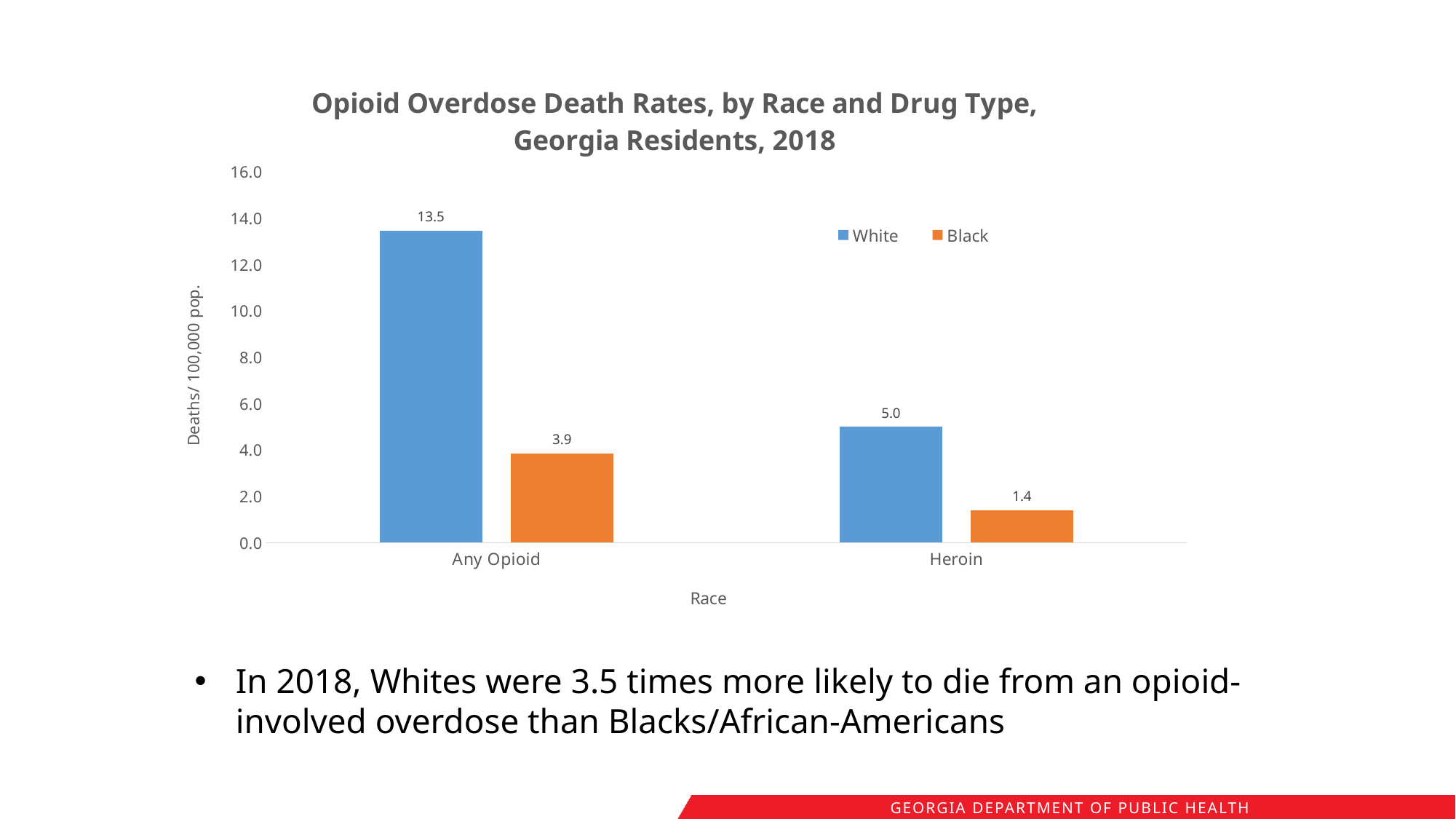
What is the death rate for Black residents for Any Opioid? 3.9 What is the death rate for White residents for Heroin? 5.0 How many drug type categories are shown on the x axis? 2 What is the opioid overdose death rate for Black residents for Heroin? 1.4 What kind of chart is shown on the slide? Bar chart What is the opioid overdose death rate for White residents for Any Opioid? 13.5 What is the difference between the White and Black death rates for Any Opioid? 9.6 How many series does the legend list? 2 Which bar has the lowest value on the chart? Black, Heroin Which bar has the highest value on the chart? White, Any Opioid What is the difference between the White and Black death rates for Heroin? 3.6 Which is larger, the Black rate for Any Opioid or the White rate for Heroin? White rate for Heroin